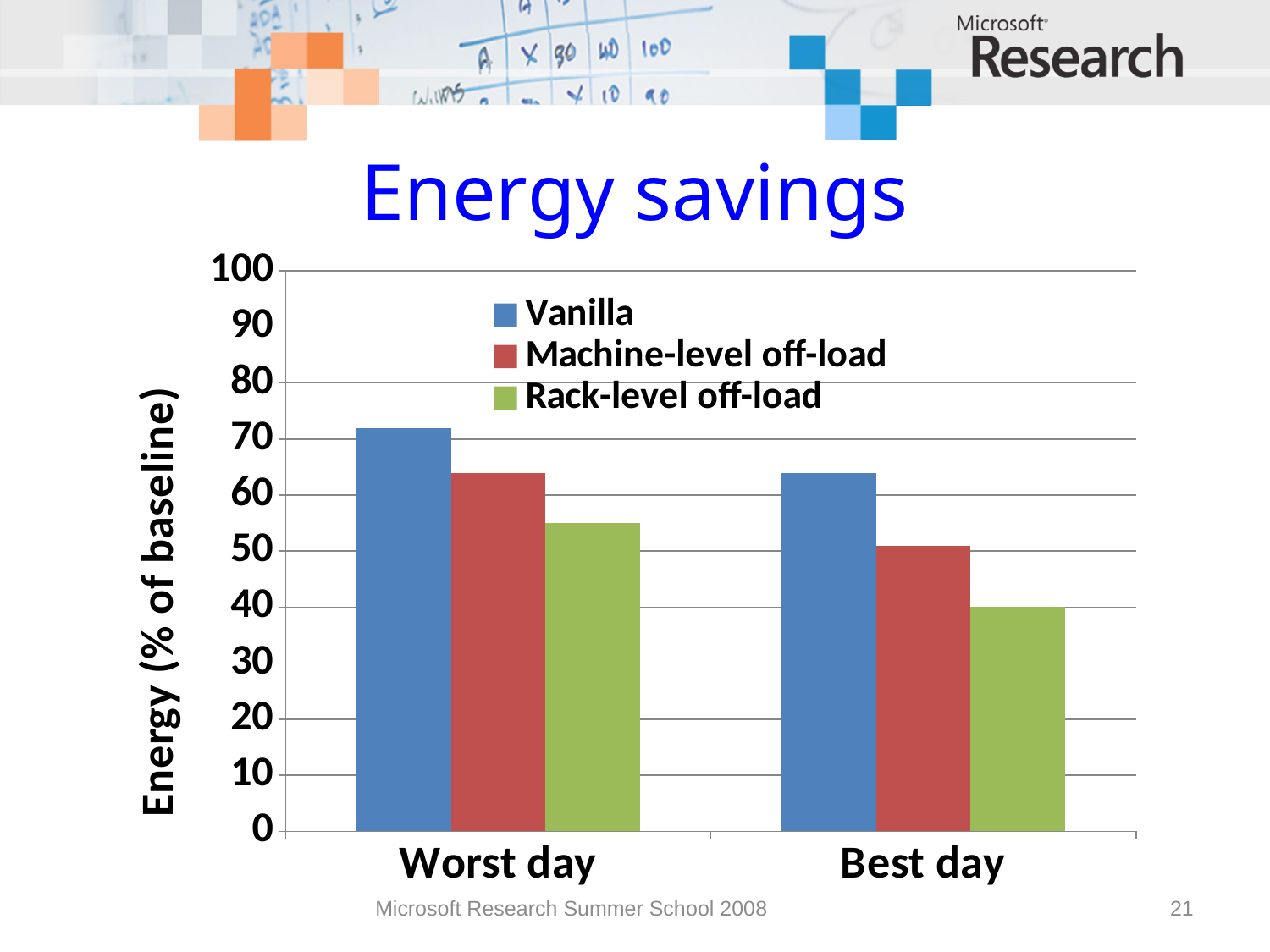
Which is larger: the Vanilla value for Best day or the Machine-level off-load value for Best day? Vanilla value for Best day How many series does the legend list? 3 Is the Rack-level off-load value for Worst day greater or less than 50? greater How many categories are shown on the x axis? 2 Which series has the highest value for Worst day? Vanilla What kind of chart is shown on the slide? bar chart Does the Rack-level off-load value rise or fall from Worst day to Best day? fall What is the label of the y axis? Energy (% of baseline) Which series has the lowest value for Best day? Rack-level off-load What is the title of the chart? Energy savings Is the Machine-level off-load value for Best day greater or less than 60? less Is the Vanilla value for Worst day greater or less than 70? greater